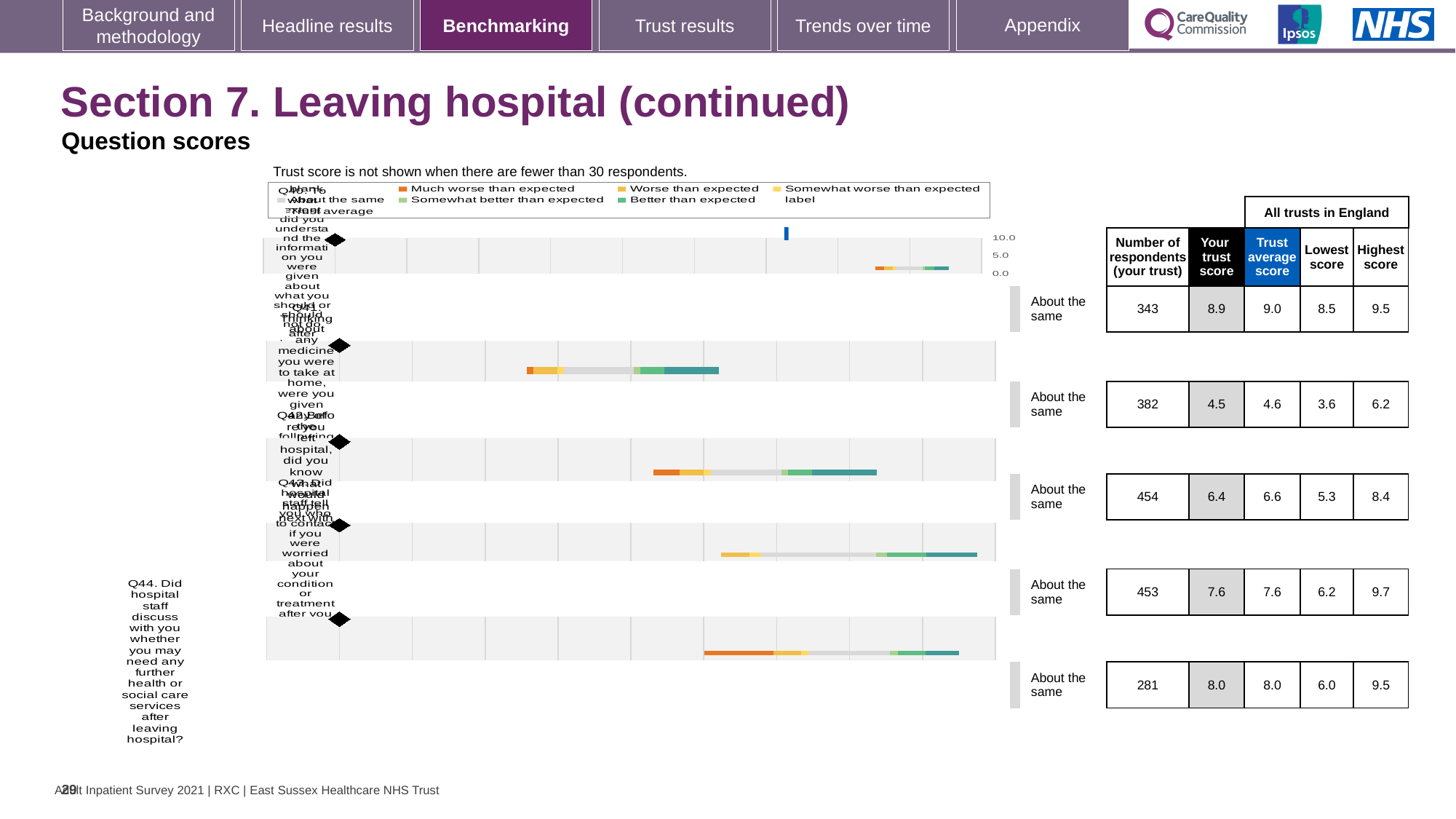
Which has more respondents: the top row (343) or the bottom row Q44 (281)? the top row What is the difference between the highest score and the lowest score for Q44 (the bottom row)? 3.5 What benchmark category is shown next to every question row? About the same Which row has the highest 'Your trust score' in the table? the top row (8.9) What is the 'Your trust score' for Q44 (the bottom row, about further health or social care services after leaving hospital)? 8.0 Which row has the lowest 'Your trust score' in the table? the second row (4.5) What kind of chart is used to show the question scores on this slide? bar chart How many respondents does the table show for Q44 (the bottom row)? 281 What is the trust average score for the top row of the table? 9.0 What is the highest score across all trusts in England for Q44 (the bottom row)? 9.5 How many question rows are plotted in the chart? 5